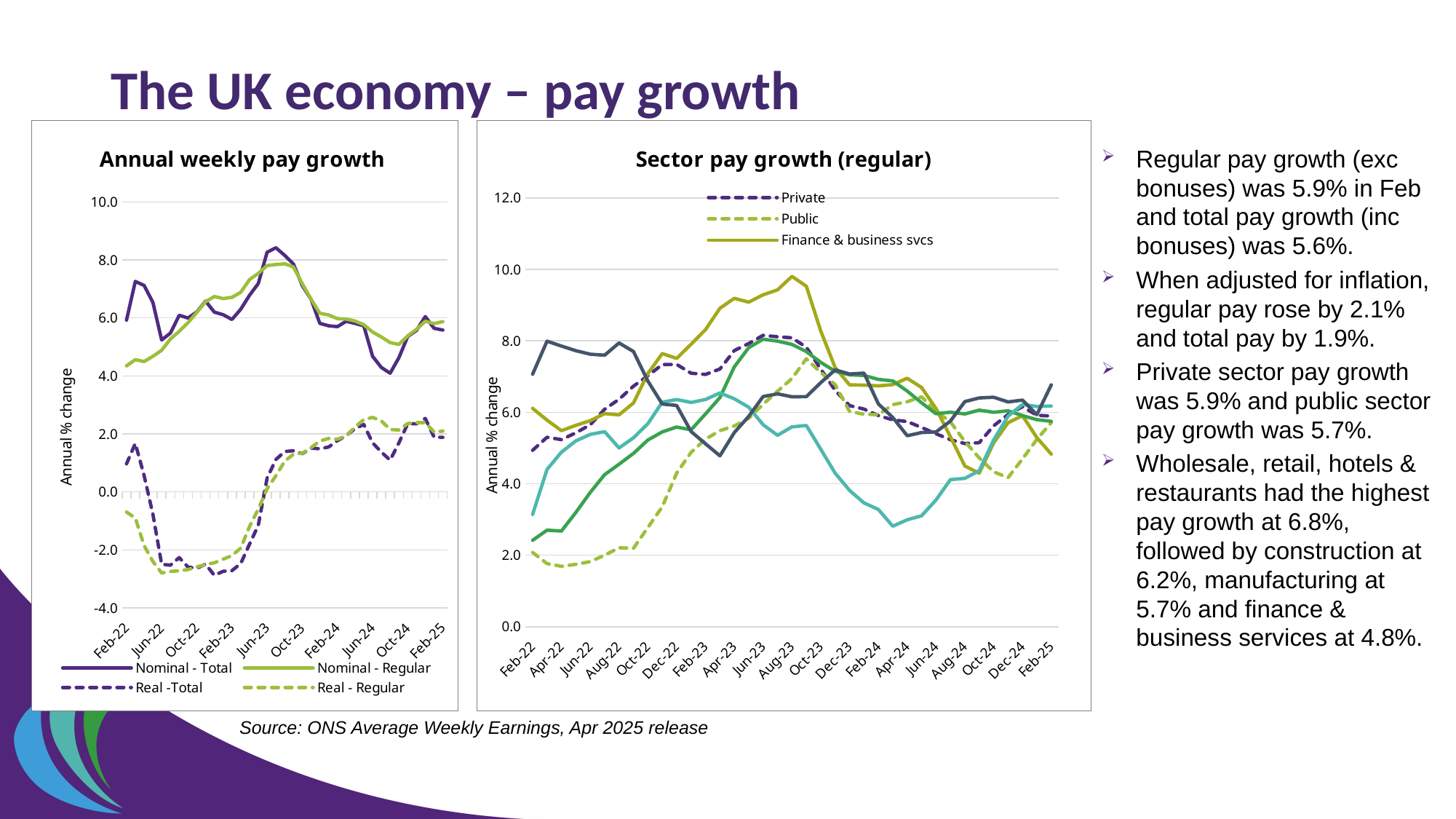
How many series does the legend of the 'Sector pay growth (regular)' chart list? 3 In the 'Annual weekly pay growth' chart, which is larger at Jun-22: Nominal - Total or Real -Total? Nominal - Total What is the y-axis label on the 'Sector pay growth (regular)' chart? Annual % change In the 'Annual weekly pay growth' chart, is the value of Nominal - Regular at Feb-22 greater or less than 4.0? greater What type of chart is the 'Annual weekly pay growth' chart? Line chart In the 'Sector pay growth (regular)' chart, is the peak value of Finance & business svcs greater or less than 8.0? greater How many series does the legend of the 'Annual weekly pay growth' chart list? 4 In the 'Sector pay growth (regular)' chart, is the value of Finance & business svcs at Feb-25 greater or less than 6.0? less In the 'Annual weekly pay growth' chart, does the Real -Total line rise or fall between Feb-22 and Jun-22? Fall In the 'Sector pay growth (regular)' chart, which of the legend series reaches the highest value? Finance & business svcs In the 'Sector pay growth (regular)' chart, does the Finance & business svcs line rise or fall between Feb-22 and Aug-23? Rise